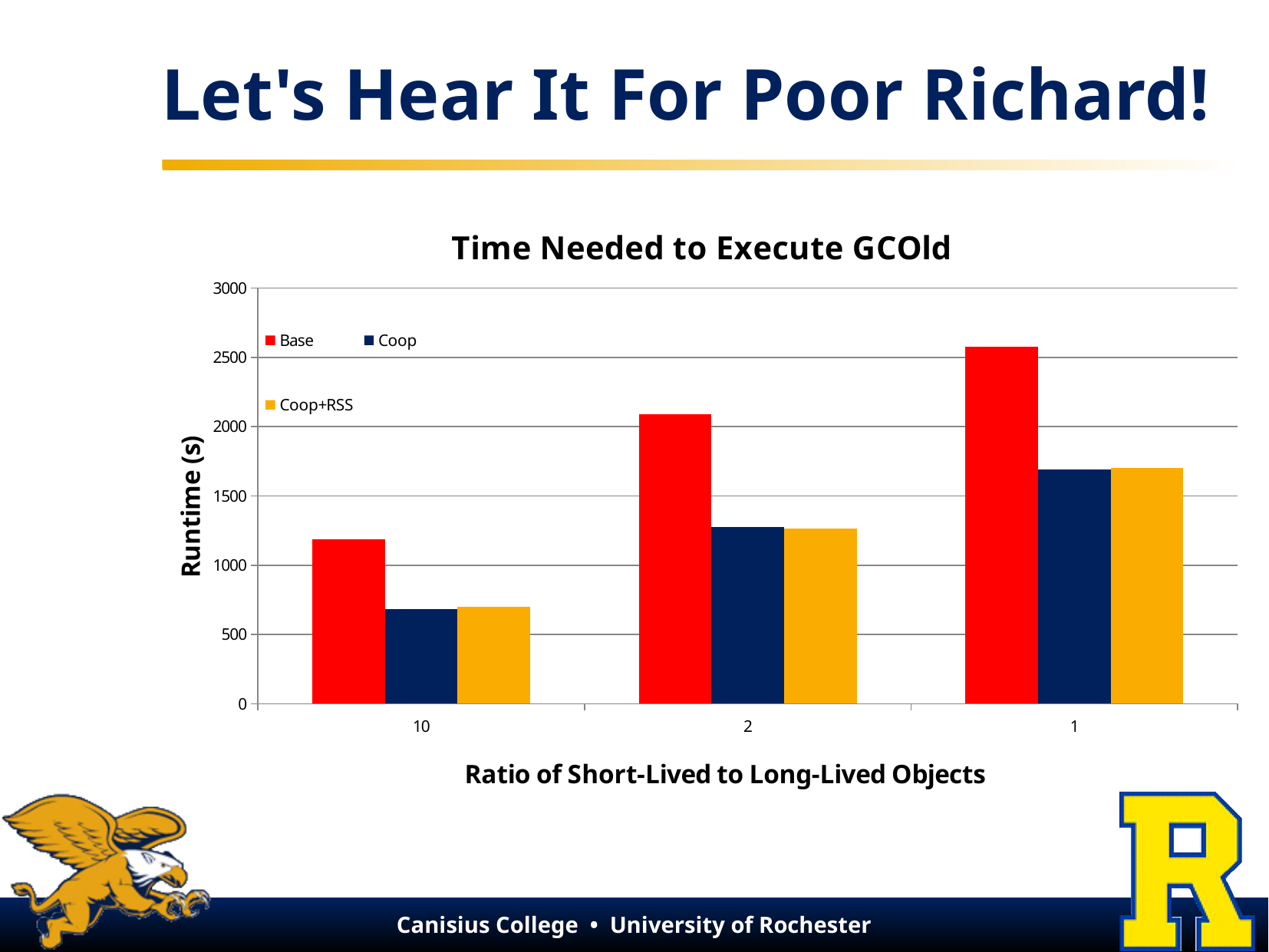
What kind of chart is shown on the slide? bar chart Do the Base runtimes rise or fall moving left to right along the x axis? rise Is the Coop+RSS runtime at a ratio of 1 greater or less than 1500? greater At a ratio of 2, which has the larger runtime, Base or Coop? Base What is the title of the chart? Time Needed to Execute GCOld How many series does the legend list? 3 Is the Base runtime at a ratio of 2 greater or less than 2000? greater How many ratio categories are shown on the x axis? 3 Is the Base runtime at a ratio of 1 greater or less than 2500? greater For which ratio of short-lived to long-lived objects is the Base runtime lowest? 10 For which ratio of short-lived to long-lived objects is the Base runtime highest? 1